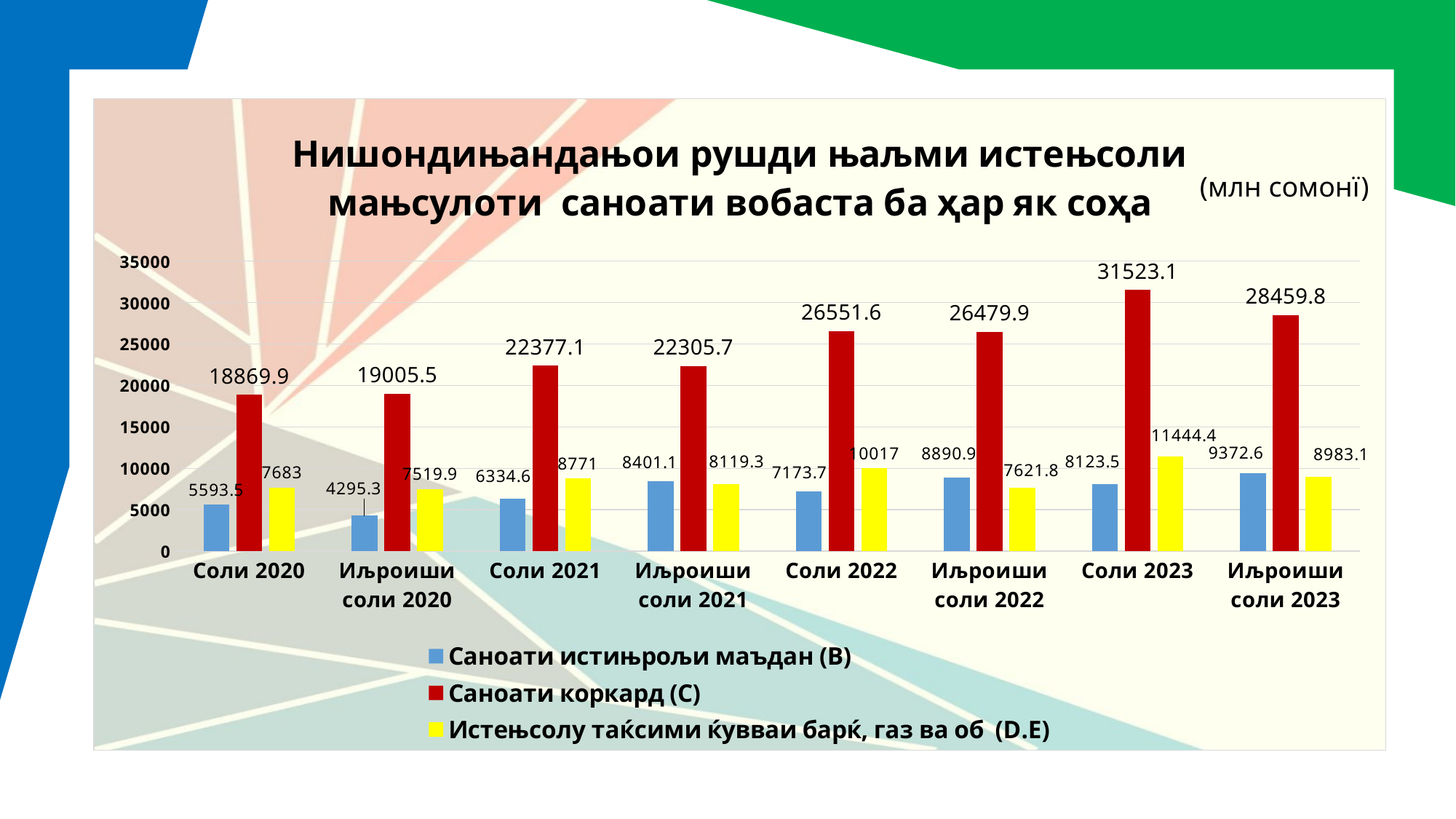
How many categories are shown along the x axis? 8 What is the value of Саноати истињрољи маъдан (B) for Иљроиши соли 2021? 8401.1 What is the value of Саноати коркард (C) for Соли 2023? 31523.1 Does Саноати коркард (C) generally rise or fall from Соли 2020 to Соли 2023? rise Which is larger: Саноати истињрољи маъдан (B) for Иљроиши соли 2023 or Истењсолу таќсими ќувваи барќ, газ ва об (D.E) for Иљроиши соли 2023? Саноати истињрољи маъдан (B) What is the difference between Саноати коркард (C) for Соли 2023 and for Иљроиши соли 2023? 3063.3 In which category is Саноати истињрољи маъдан (B) lowest? Иљроиши соли 2020 What unit is given next to the chart title? млн сомонї In which category is Саноати коркард (C) highest? Соли 2023 What is the value of Истењсолу таќсими ќувваи барќ, газ ва об (D.E) for Соли 2022? 10017 What type of chart is shown on the slide? bar chart How many series does the legend list? 3